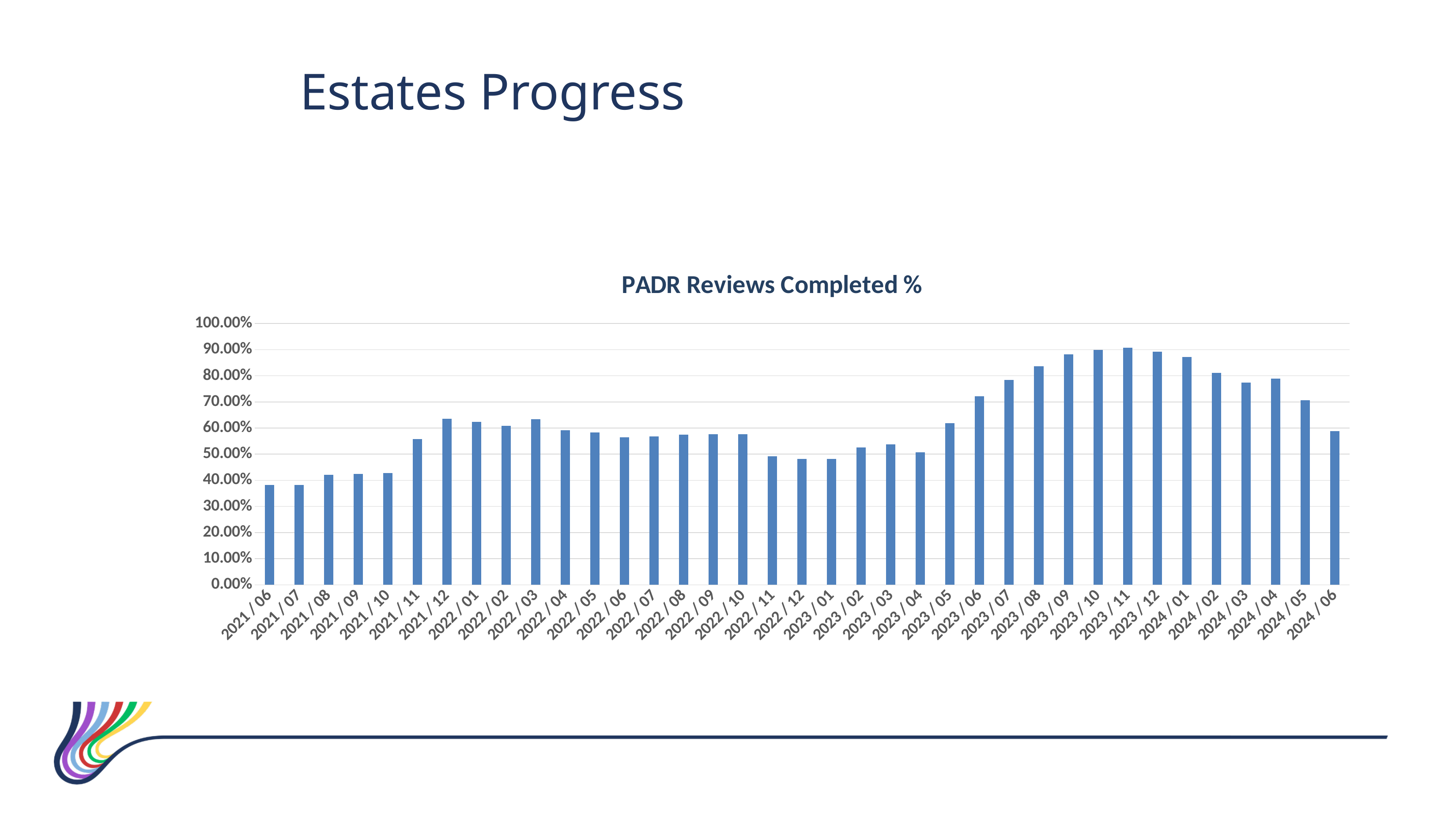
Is the value for 2021 / 12 greater or less than 60.00%? greater How many months (bars) are plotted on the chart? 37 Is the value for 2021 / 06 greater or less than 40.00%? less What is the title of the chart? PADR Reviews Completed % Is the value for 2023 / 09 greater or less than 80.00%? greater What kind of chart is shown on the slide? bar chart Do the values rise or fall from 2023 / 11 to 2024 / 06? fall Which is larger, the value for 2023 / 09 or the value for 2021 / 06? 2023 / 09 Which is larger, the value for 2022 / 01 or the value for 2022 / 11? 2022 / 01